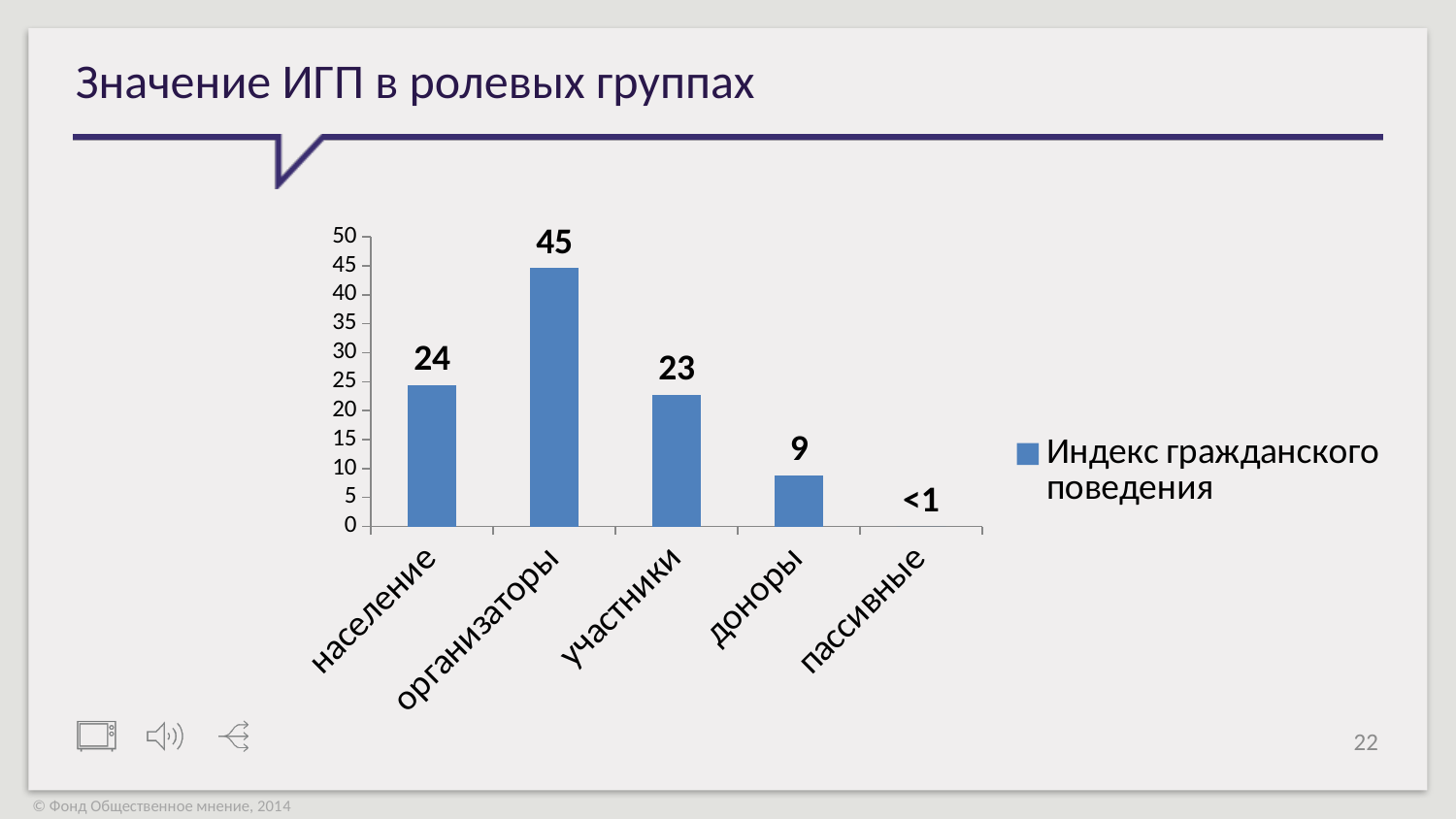
Which category has the lowest value? пассивные What is the value for организаторы? 45 What is the value for доноры? 9 How many series does the legend list? 1 What is the difference between the values for организаторы and участники? 22 What kind of chart is shown on the slide? bar chart How many categories are shown on the x axis? 5 What is the data label shown for пассивные? <1 Which is larger, the value for население or the value for доноры? население What is the value for население? 24 Which category has the highest value? организаторы Is the value for участники greater or less than 30? less